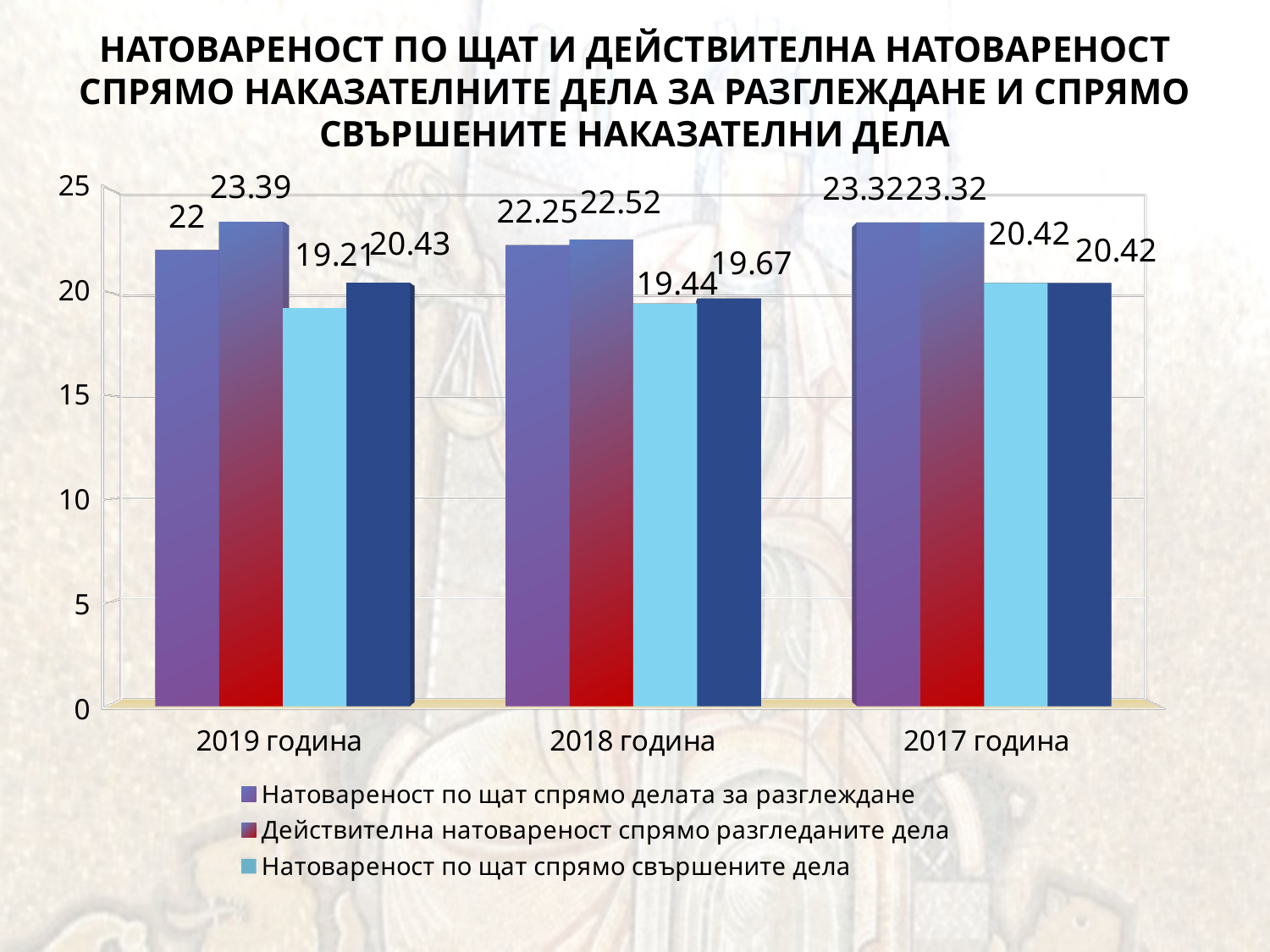
For 2018 година, which is larger: "Натовареност по щат спрямо делата за разглеждане" or "Действителна натовареност спрямо разгледаните дела"? Действителна натовареност спрямо разгледаните дела What is the value of "Натовареност по щат спрямо делата за разглеждане" for 2019 година? 22 What kind of chart is shown on the slide? bar chart What is the value of "Действителна натовареност спрямо разгледаните дела" for 2018 година? 22.52 In which year is "Натовареност по щат спрямо свършените дела" the lowest? 2019 година For 2019 година, what is the difference between "Действителна натовареност спрямо разгледаните дела" and "Натовареност по щат спрямо делата за разглеждане"? 1.39 How many series does the legend list? 3 How many year categories are shown on the x axis? 3 Is the value of "Натовареност по щат спрямо свършените дела" for 2019 година greater or less than 20? less For 2017 година, what is the difference between "Действителна натовареност спрямо разгледаните дела" and "Натовареност по щат спрямо свършените дела"? 2.9 In which year is "Натовареност по щат спрямо делата за разглеждане" the highest? 2017 година What is the value of "Натовареност по щат спрямо свършените дела" for 2017 година? 20.42